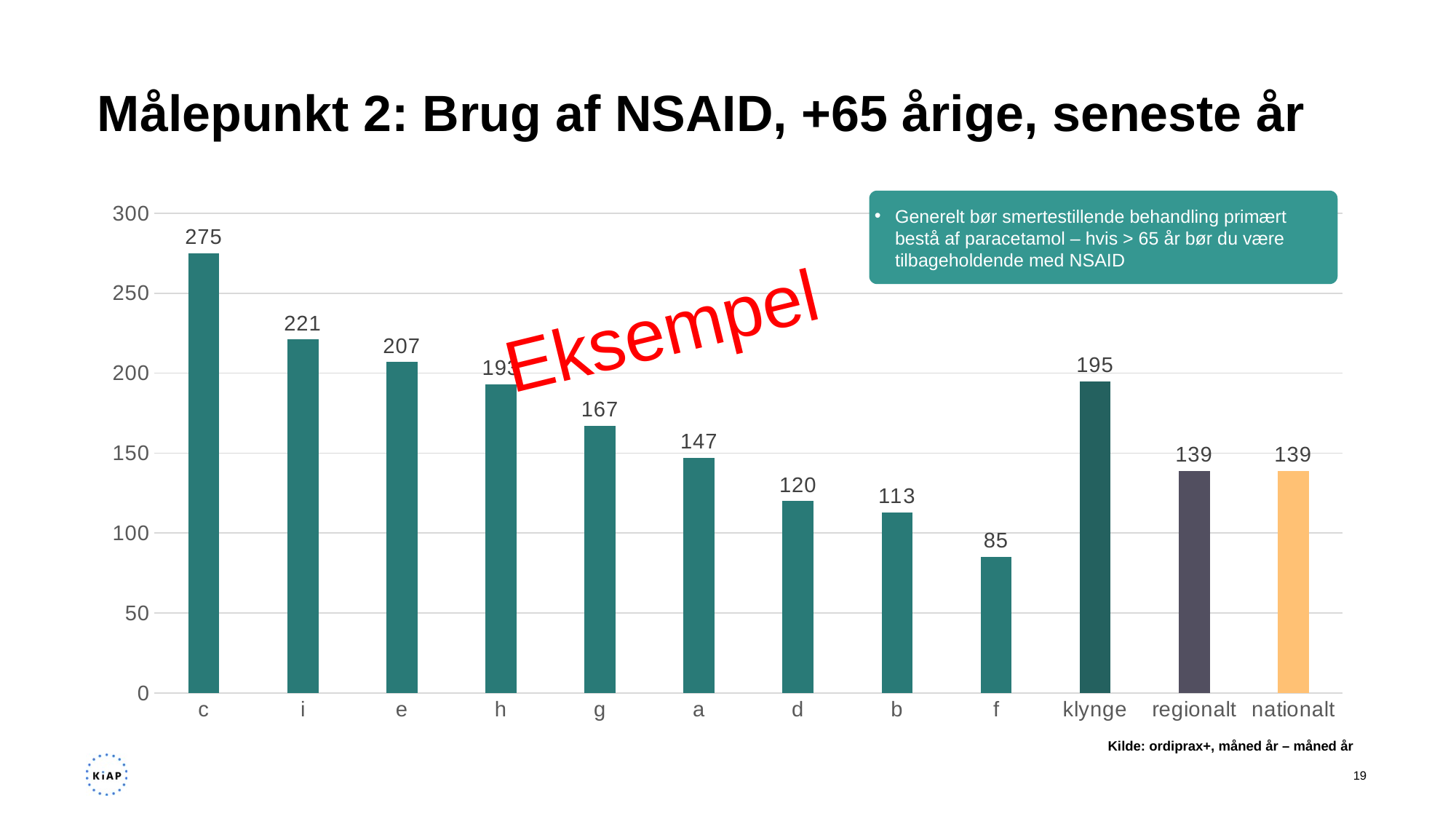
Is the value for category h greater or less than 150? greater How many bars are shown in the chart? 12 What is the value for category f? 85 Which category has the lowest value? f What is the value for klynge? 195 What type of chart is shown on the slide? bar chart What is the difference between the values for c and i? 54 What is the value for nationalt? 139 Which category has the highest value? c What is the difference between the values for klynge and regionalt? 56 Which is larger, the value for g or the value for a? g What is the value for category c? 275